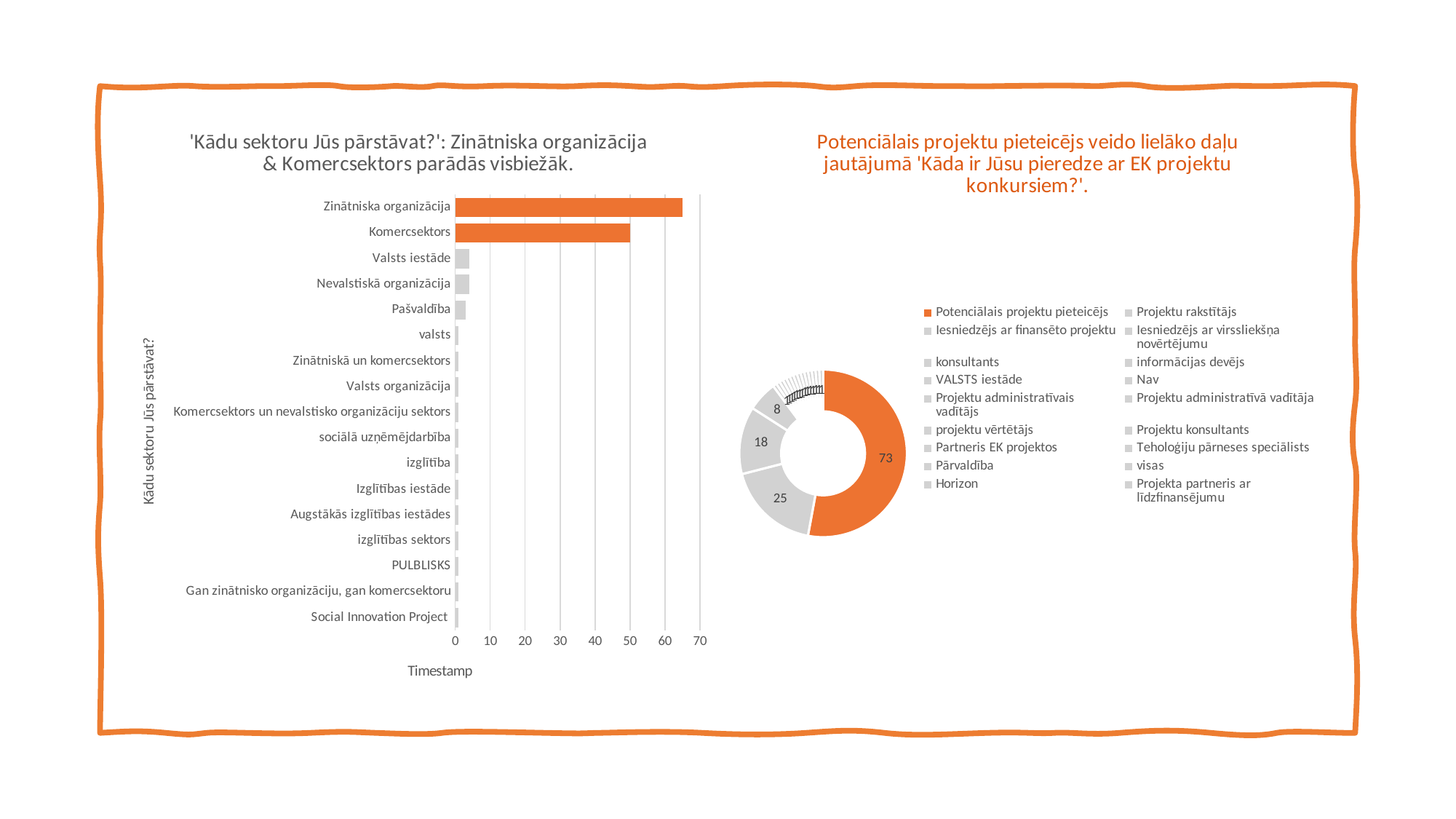
In the left bar chart, which category has the highest value? Zinātniska organizācija In the right doughnut chart, what is the difference between the two largest labelled slices, 73 and 25? 48 What is the x-axis title of the left bar chart? Timestamp In the left bar chart, which is larger, Zinātniska organizācija or Komercsektors? Zinātniska organizācija What kind of chart is the chart on the left of the slide? bar chart How many categories are listed on the y axis of the left bar chart? 17 In the left bar chart, is the value for Komercsektors greater or less than 40? greater In the left bar chart, is the value for Valsts iestāde greater or less than 10? less In the right doughnut chart, what is the value of the largest slice? 73 In the left bar chart, is the value for Zinātniska organizācija greater or less than 60? greater How many entries does the legend of the right doughnut chart list? 18 What kind of chart is the chart on the right of the slide? doughnut chart